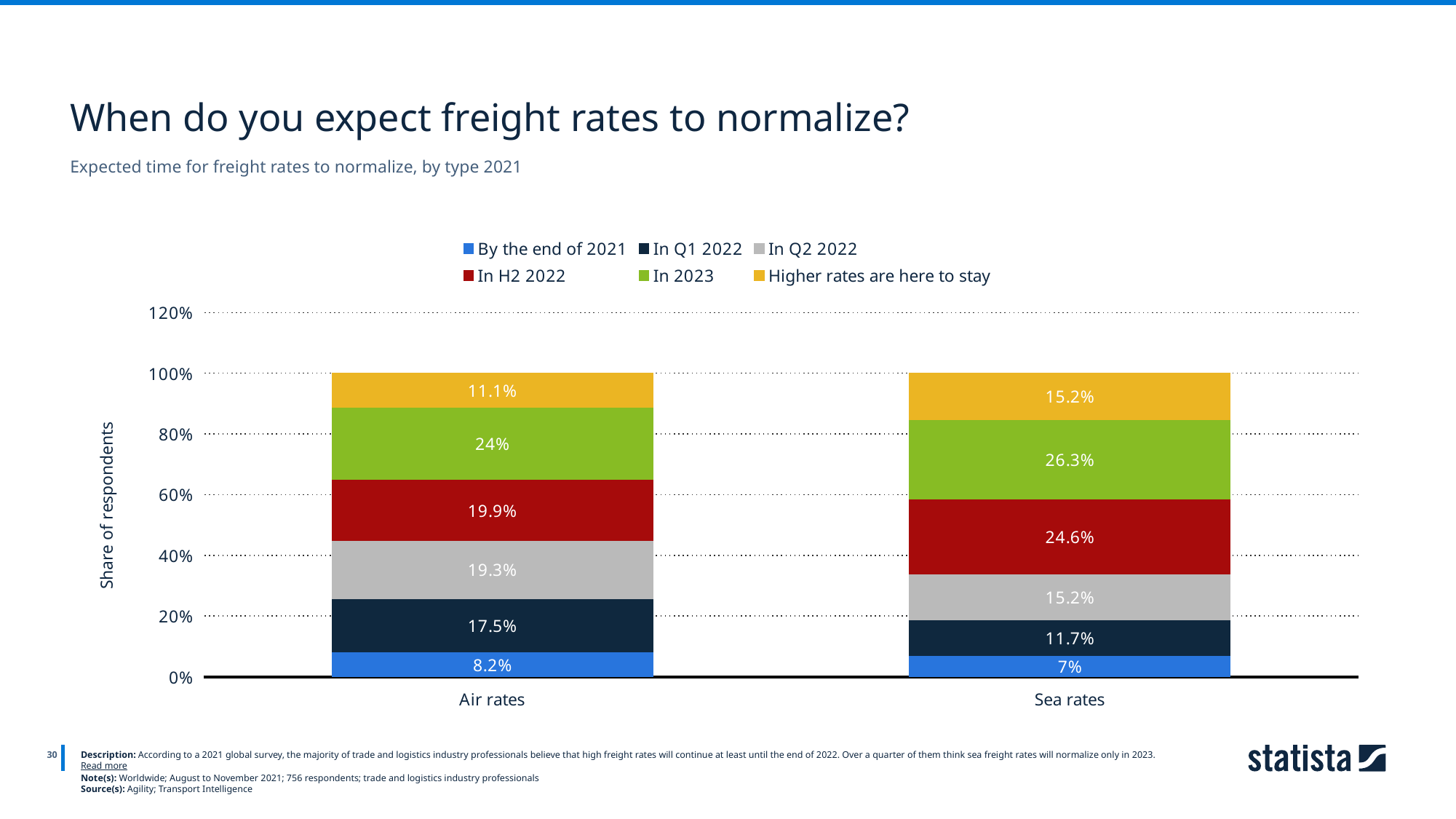
How many categories are shown on the x axis? 2 What share of respondents expect air rates to normalize in 2023? 24% What is the value for 'In Q1 2022' in the Air rates bar? 17.5% Which response option has the smallest share for Air rates? By the end of 2021 How many series does the legend list? 6 What is the total of the Air rates stacked bar? 100% Which is larger: the 'In Q2 2022' share for Air rates or for Sea rates? Air rates Which response option has the largest share for Sea rates? In 2023 What is the value for 'By the end of 2021' in the Sea rates bar? 7% What kind of chart is shown on the slide? Stacked bar chart What is the difference between the 'Higher rates are here to stay' shares for Sea rates and Air rates? 4.1% What share of respondents expect sea rates to normalize in H2 2022? 24.6%